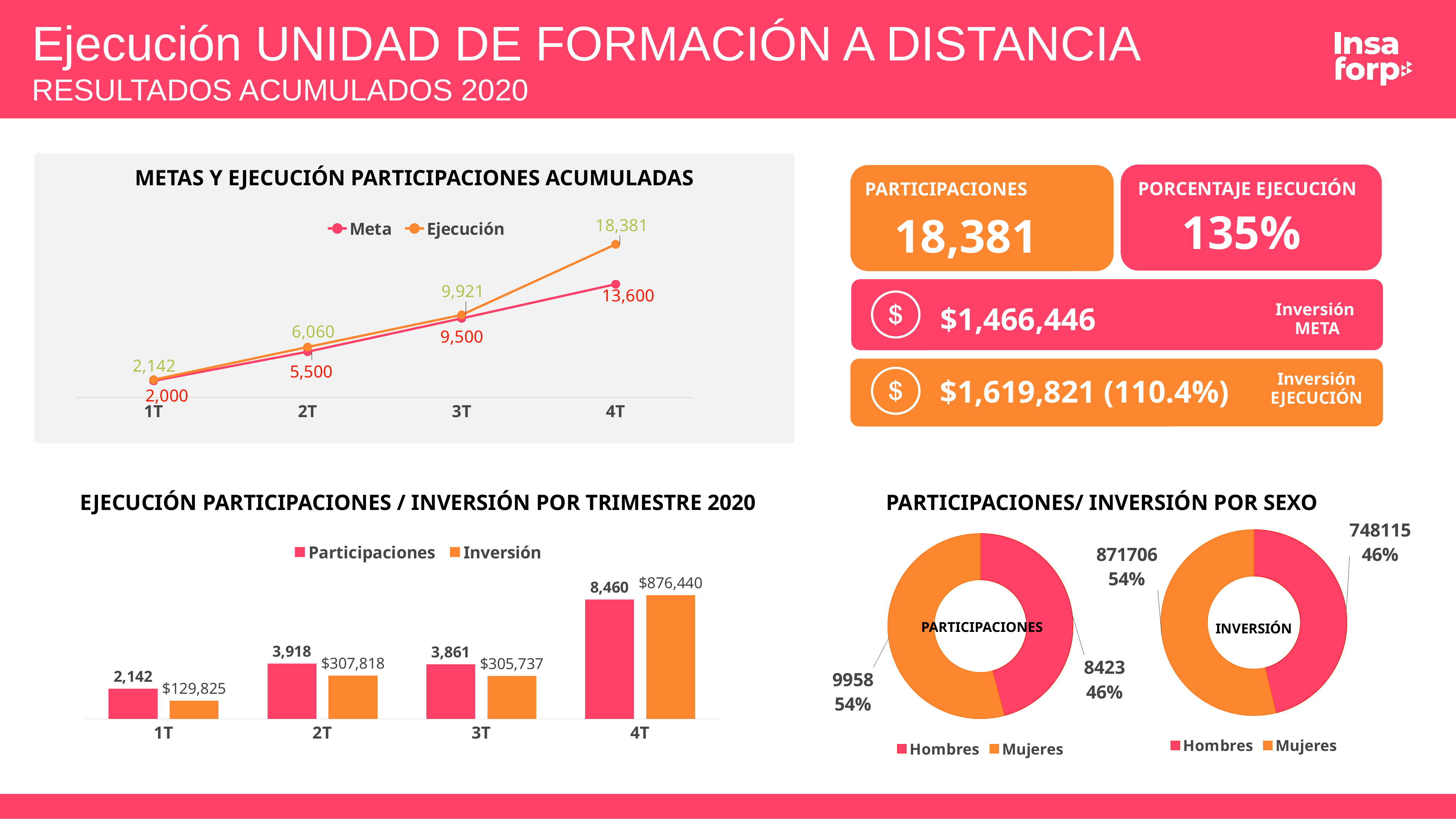
In the chart titled 'METAS Y EJECUCIÓN PARTICIPACIONES ACUMULADAS', what kind of chart is it? Line chart In the chart titled 'METAS Y EJECUCIÓN PARTICIPACIONES ACUMULADAS', what is the Meta value at 2T? 5,500 In the chart titled 'METAS Y EJECUCIÓN PARTICIPACIONES ACUMULADAS', do the Meta values rise or fall from 1T to 4T? Rise In the chart titled 'EJECUCIÓN PARTICIPACIONES / INVERSIÓN POR TRIMESTRE 2020', what is the Inversión value for 3T? $305,737 In the chart titled 'EJECUCIÓN PARTICIPACIONES / INVERSIÓN POR TRIMESTRE 2020', what kind of chart is it? Bar chart In the INVERSIÓN donut chart under 'PARTICIPACIONES/ INVERSIÓN POR SEXO', what is the value for Hombres? 748115 In the chart titled 'EJECUCIÓN PARTICIPACIONES / INVERSIÓN POR TRIMESTRE 2020', which quarter has the highest Participaciones value? 4T In the chart titled 'METAS Y EJECUCIÓN PARTICIPACIONES ACUMULADAS', what is the Ejecución value at 4T? 18,381 In the chart titled 'EJECUCIÓN PARTICIPACIONES / INVERSIÓN POR TRIMESTRE 2020', what is the difference in Participaciones between 2T and 3T? 57 In the chart titled 'EJECUCIÓN PARTICIPACIONES / INVERSIÓN POR TRIMESTRE 2020', how many series does the legend list? 2 In the chart titled 'METAS Y EJECUCIÓN PARTICIPACIONES ACUMULADAS', what is the difference between Ejecución and Meta at 4T? 4,781 In the PARTICIPACIONES donut chart under 'PARTICIPACIONES/ INVERSIÓN POR SEXO', what share of participations corresponds to Mujeres? 54%